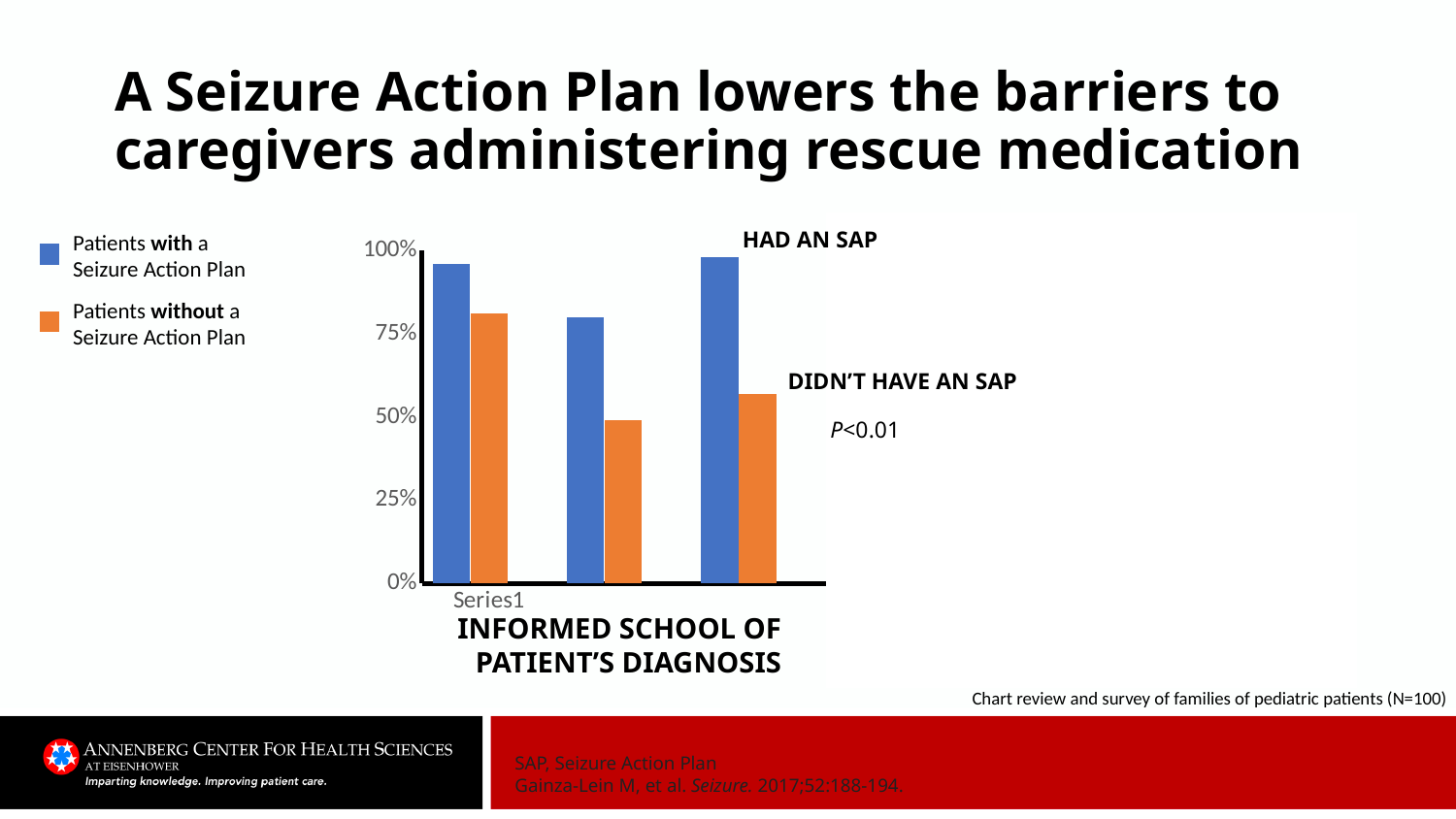
In the first group of bars (Series1), which is larger: the bar for patients with a Seizure Action Plan or the bar for patients without one? Patients with a Seizure Action Plan In the second group of bars from the left, is the value for patients with a Seizure Action Plan greater or less than 50%? greater How many groups of bars are plotted in the chart? 3 Which colour represents patients with a Seizure Action Plan? blue In the third group of bars from the left, is the value for patients with a Seizure Action Plan greater or less than 75%? greater In the first group of bars (Series1), is the value for patients with a Seizure Action Plan greater or less than 75%? greater Which colour represents patients without a Seizure Action Plan? orange In the second group of bars from the left, which is larger: the bar for patients with a Seizure Action Plan or the bar for patients without one? Patients with a Seizure Action Plan Which group of bars has the lowest value for patients without a Seizure Action Plan? the second group from the left How many series does the legend list? 2 What kind of chart is shown on the slide? bar chart